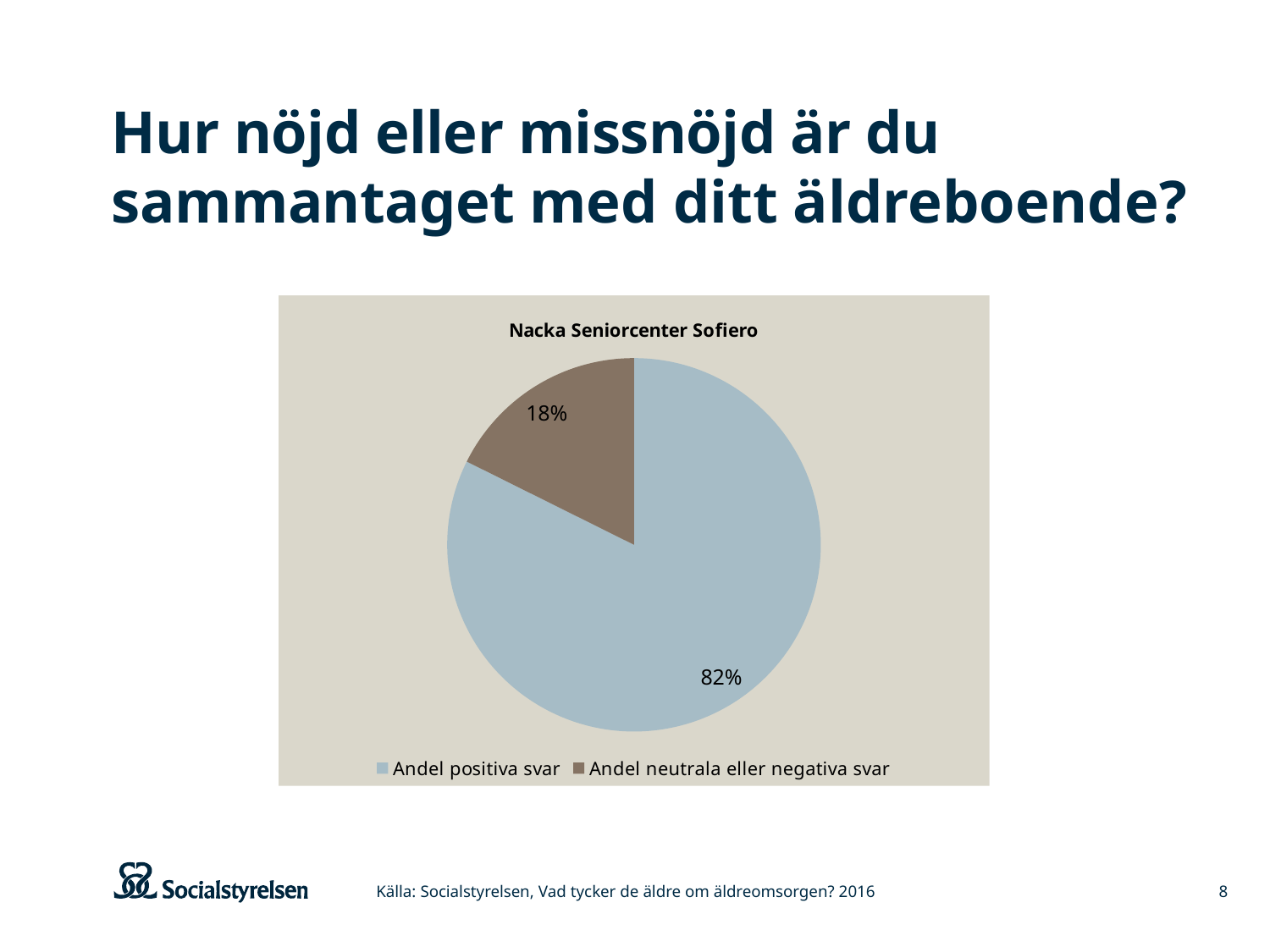
Which slice is the largest in the pie chart? Andel positiva svar What share of the pie is 'Andel positiva svar'? 82% How many entries does the legend list? 2 What share of the pie is 'Andel neutrala eller negativa svar'? 18% What kind of chart is shown on the slide? Pie chart Which is larger: 'Andel positiva svar' or 'Andel neutrala eller negativa svar'? Andel positiva svar Is the share for 'Andel positiva svar' greater or less than 50%? greater How many slices does the pie chart have? 2 What is the title of the chart? Nacka Seniorcenter Sofiero Which slice is the smallest in the pie chart? Andel neutrala eller negativa svar Which legend entry is shown in brown? Andel neutrala eller negativa svar What is the difference in percentage points between 'Andel positiva svar' and 'Andel neutrala eller negativa svar'? 64 percentage points